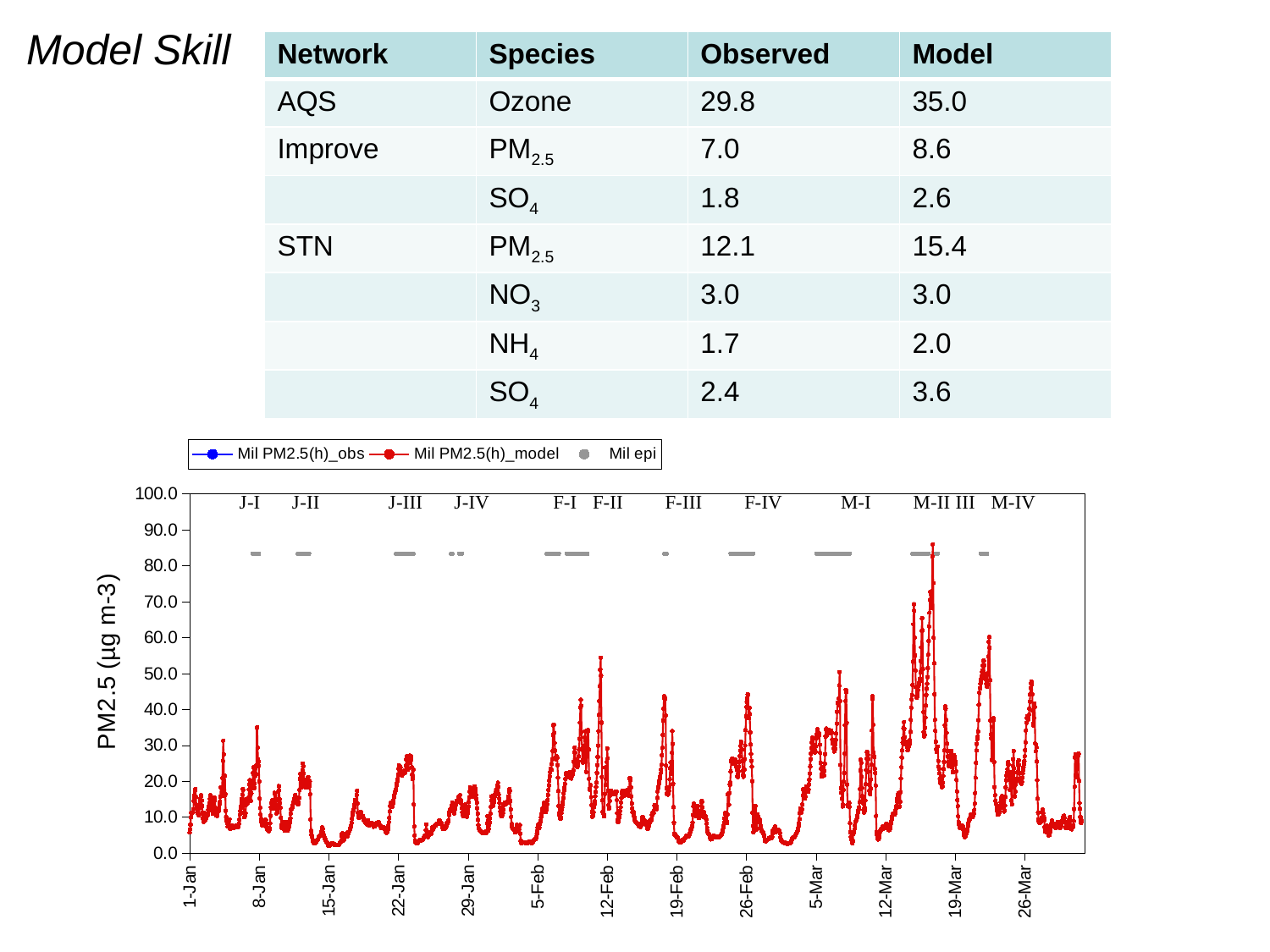
In the PM2.5 chart, between which two x-axis dates does the highest peak of the red model line occur? between 12-Mar and 19-Mar What kind of chart is shown at the bottom of the slide? line chart In the PM2.5 chart, is the peak of the red model line just before 12-Feb greater or less than 40? greater In the PM2.5 chart, are the values of the red model line around 15-Jan greater or less than 10? less In the PM2.5 chart, is the highest peak of the red model line greater or less than 70? greater How many series does the legend of the PM2.5 chart list? 3 In the PM2.5 chart, which is larger: the peak of the red model line near 26-Mar or the peak between 12-Mar and 19-Mar? the peak between 12-Mar and 19-Mar In the PM2.5 chart, which is larger: the peak of the red model line near 8-Jan or the peak just before 12-Feb? the peak just before 12-Feb What are the three legend entries of the PM2.5 chart? Mil PM2.5(h)_obs, Mil PM2.5(h)_model, Mil epi What is the y-axis label of the PM2.5 chart? PM2.5 (µg m-3)